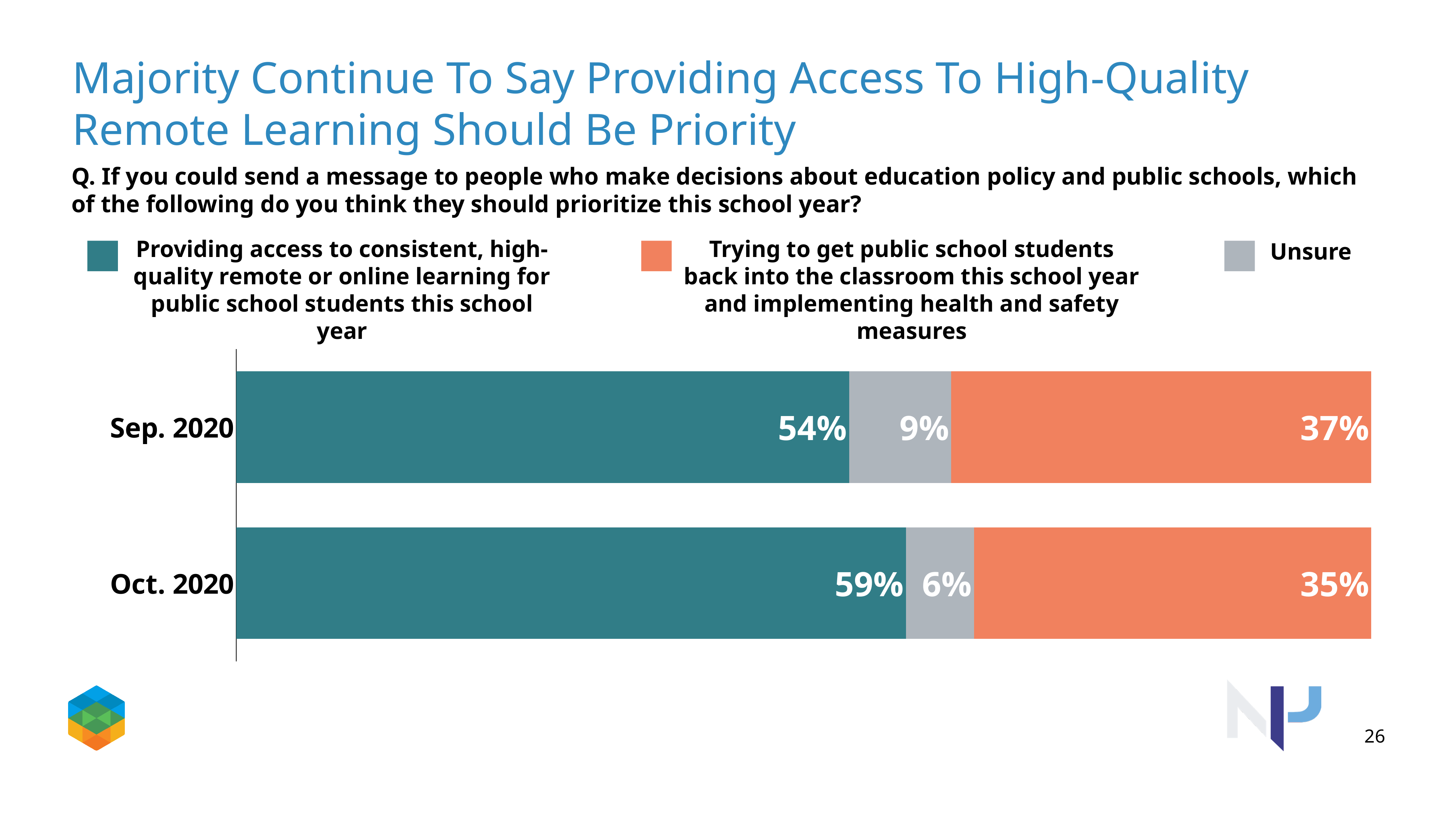
What percentage of respondents in Sep. 2020 said trying to get public school students back into the classroom should be the priority? 37% What percentage of respondents were unsure in Sep. 2020? 9% Which month had the larger share of respondents who were unsure, Sep. 2020 or Oct. 2020? Sep. 2020 What percentage of respondents were unsure in Oct. 2020? 6% How many time periods (bars) are shown in the chart? 2 In Oct. 2020, which response was chosen by the largest share of respondents? Providing access to consistent, high-quality remote or online learning for public school students this school year By how many percentage points did the share choosing high-quality remote or online learning change from Sep. 2020 to Oct. 2020? 5 percentage points What percentage of respondents in Oct. 2020 said trying to get public school students back into the classroom should be the priority? 35% What type of chart is shown on the slide? Stacked bar chart What percentage of respondents in Oct. 2020 said providing access to consistent, high-quality remote or online learning should be the priority? 59% How many series does the legend list? 3 What percentage of respondents in Sep. 2020 said providing access to consistent, high-quality remote or online learning should be the priority? 54%